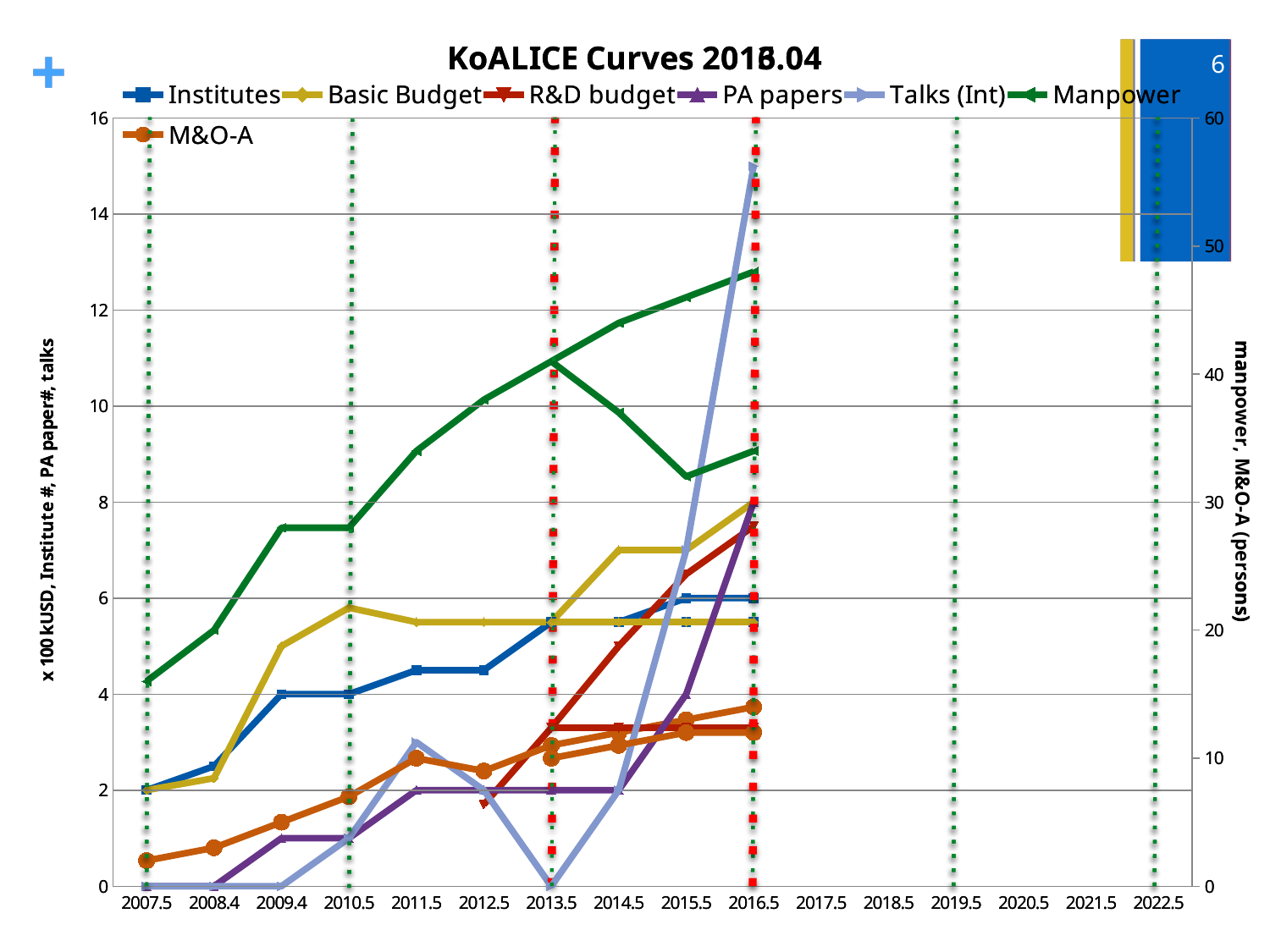
What is the value of the Institutes series at 2007.5? 2 What is the value of the Talks (Int) series at 2013.5? 0 Which series has the highest value on the left axis at 2016.5? Talks (Int) Does the Institutes series generally rise or fall from 2007.5 to 2016.5? rise How many tick labels are shown on the x axis? 16 How many series does the legend list? 7 What is the value of the PA papers series at 2011.5? 2 What kind of chart is shown on the slide? line chart Is the value for Talks (Int) at 2016.5 greater or less than 14? greater At 2016.5, which is larger: Basic Budget or Institutes? Basic Budget